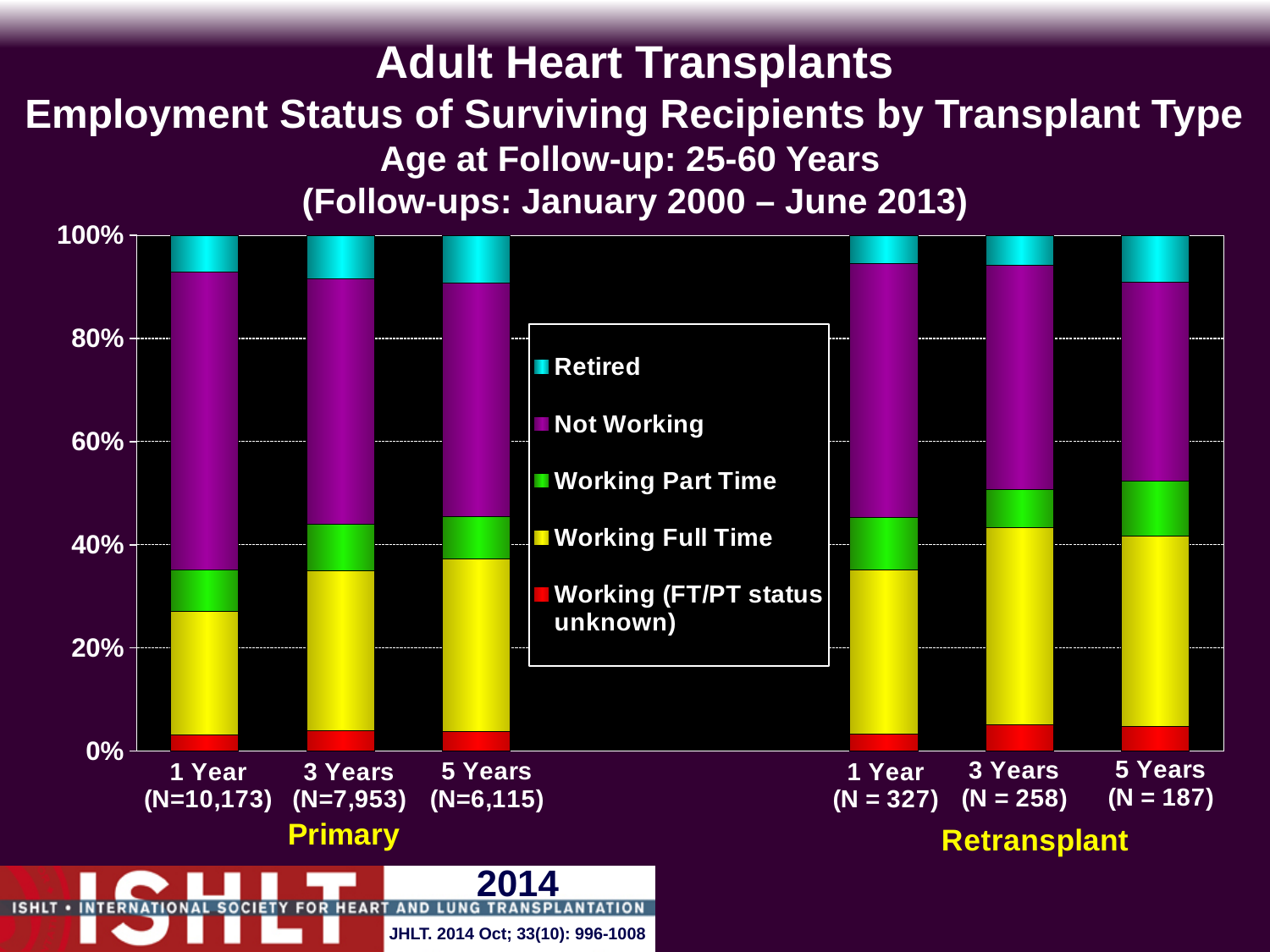
Is the Not Working share for Primary 1 Year greater or less than 40%? greater Is the Working Full Time share for Retransplant 3 Years greater or less than 20%? greater What is the sample size (N) shown for the Retransplant 5 Years bar? N = 187 Is the Working Full Time share for Primary 5 Years greater or less than 20%? greater How many series does the legend list? 5 What kind of chart is shown on the slide? Stacked bar chart Across the Primary bars, does the Not Working share rise or fall from 1 Year to 5 Years? fall Which bar has the larger Not Working segment: Primary 1 Year or Primary 5 Years? Primary 1 Year Which legend entry is shown in purple? Not Working How many bars are plotted in the chart? 6 Which bar has the larger Working Full Time segment: Primary 1 Year or Retransplant 1 Year? Retransplant 1 Year Across the Primary bars, does the Working Full Time share rise or fall from 1 Year to 5 Years? rise